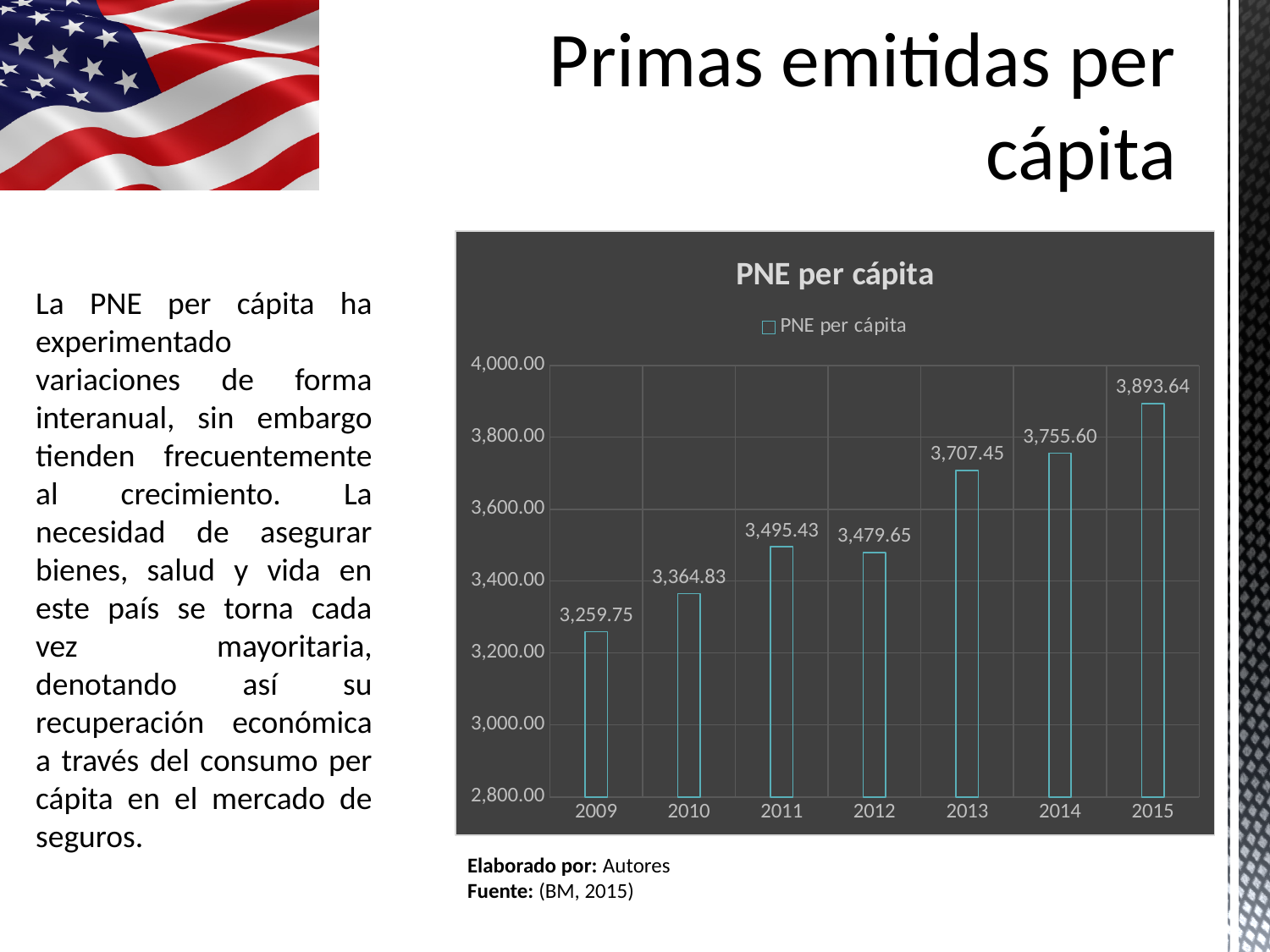
What is the difference between the PNE per cápita in 2011 and in 2012? 15.78 What is the PNE per cápita value for 2013? 3,707.45 What is the PNE per cápita value for 2015? 3,893.64 What is the title of the chart? PNE per cápita How many years are shown on the x axis of the chart? 7 Which year has the highest PNE per cápita? 2015 What is the PNE per cápita value for 2009? 3,259.75 Is the PNE per cápita for 2014 greater or less than 3,600.00? greater Which year has the lowest PNE per cápita? 2009 What kind of chart is used to show PNE per cápita? Bar chart Which year has a larger PNE per cápita, 2010 or 2012? 2012 What is the difference between the PNE per cápita in 2015 and in 2009? 633.89